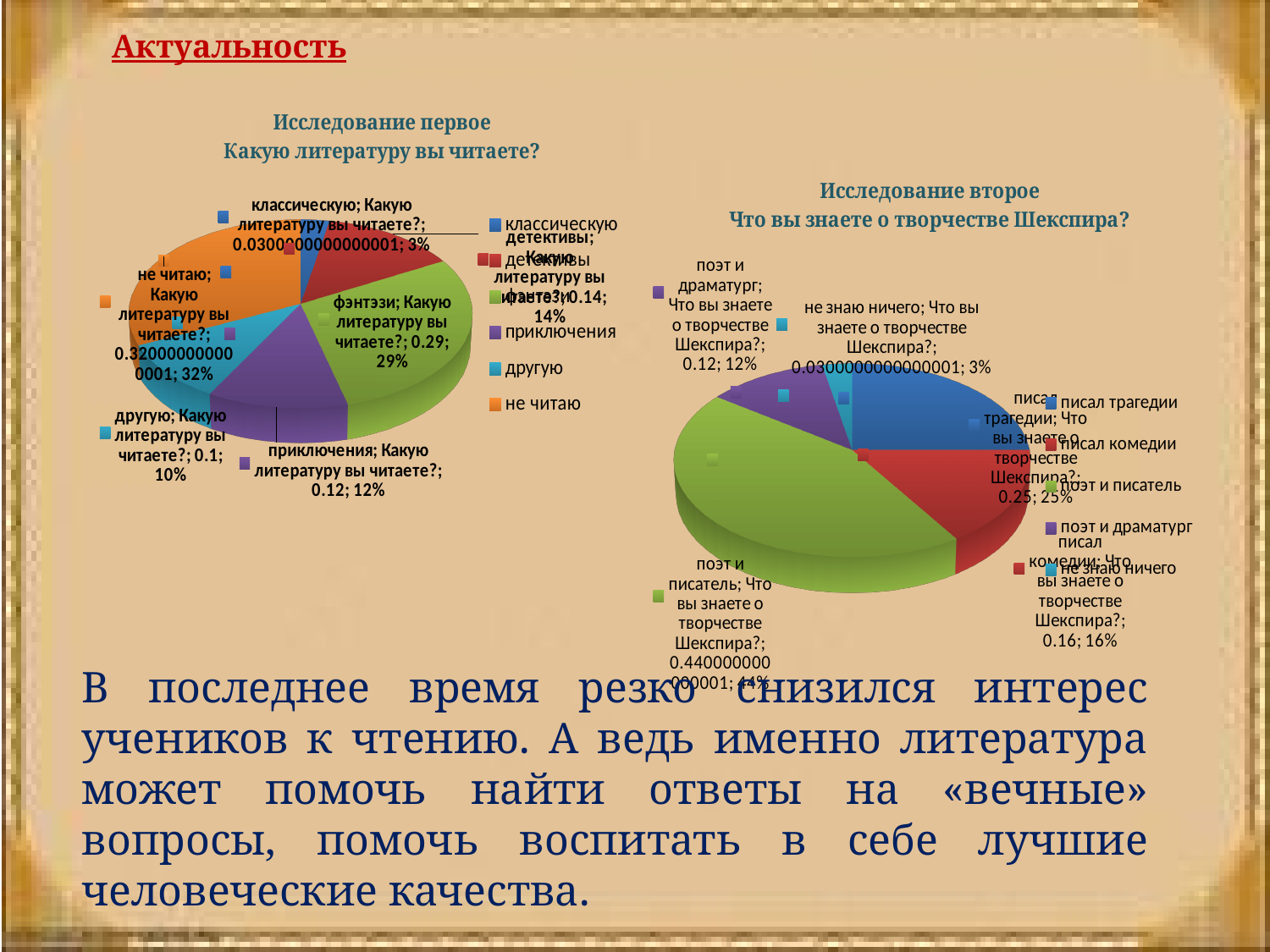
In the chart titled "Исследование второе", which answer has the largest share? поэт и писатель In the chart titled "Исследование второе", what percentage is shown for "писал комедии"? 16% In the chart titled "Исследование второе", how many categories does the legend list? 5 In the chart titled "Исследование первое", what percentage is shown for "фэнтэзи"? 29% What type of chart is used for "Исследование второе"? Pie chart In the chart titled "Исследование второе", what percentage of respondents answered "поэт и писатель"? 44% In the chart titled "Исследование первое", which category has the largest share? не читаю In the chart titled "Исследование первое", how many categories does the legend list? 6 In the chart titled "Исследование второе", which is larger: "писал трагедии" or "поэт и драматург"? писал трагедии In the chart titled "Исследование первое", what percentage of respondents answered "не читаю"? 32% In the chart titled "Исследование первое", what is the difference in percentage points between "фэнтэзи" and "детективы"? 15 In the chart titled "Исследование первое", which category has the smallest share? классическую